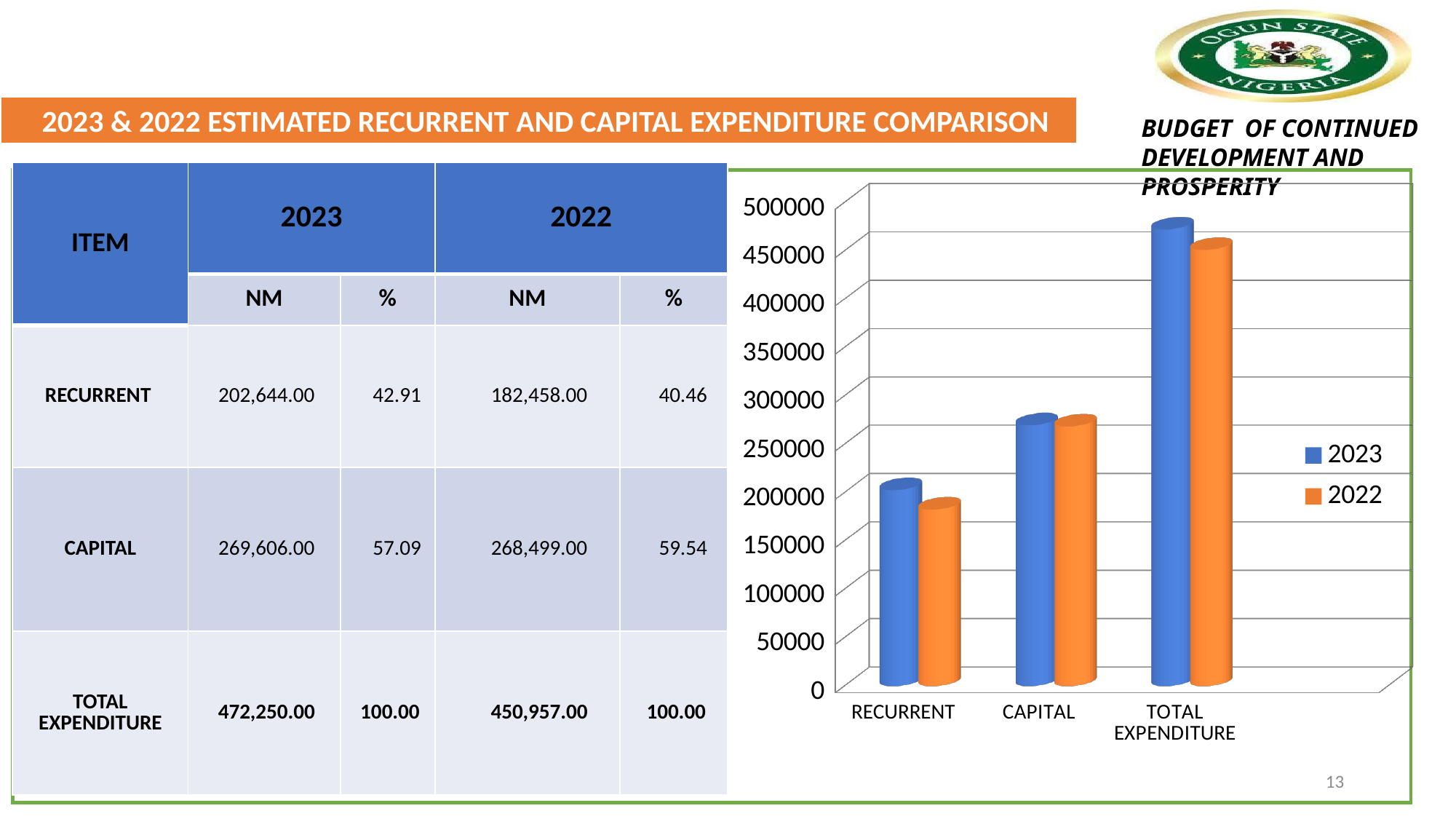
Is the 2022 value for RECURRENT greater or less than 200000? less Which category has the lowest bar for the 2022 series? RECURRENT Is the 2023 value for TOTAL EXPENDITURE greater or less than 500000? less What kind of chart is shown on the slide? bar chart Which series is shown in orange in the chart? 2022 Which category has the highest bar for the 2023 series? TOTAL EXPENDITURE For TOTAL EXPENDITURE, which series has the larger bar, 2023 or 2022? 2023 Do the 2023 bars rise or fall from RECURRENT to TOTAL EXPENDITURE along the x axis? rise How many categories are shown on the x axis of the chart? 3 How many series does the chart legend list? 2 For RECURRENT, which series has the larger bar, 2023 or 2022? 2023 Is the 2023 value for CAPITAL greater or less than 250000? greater